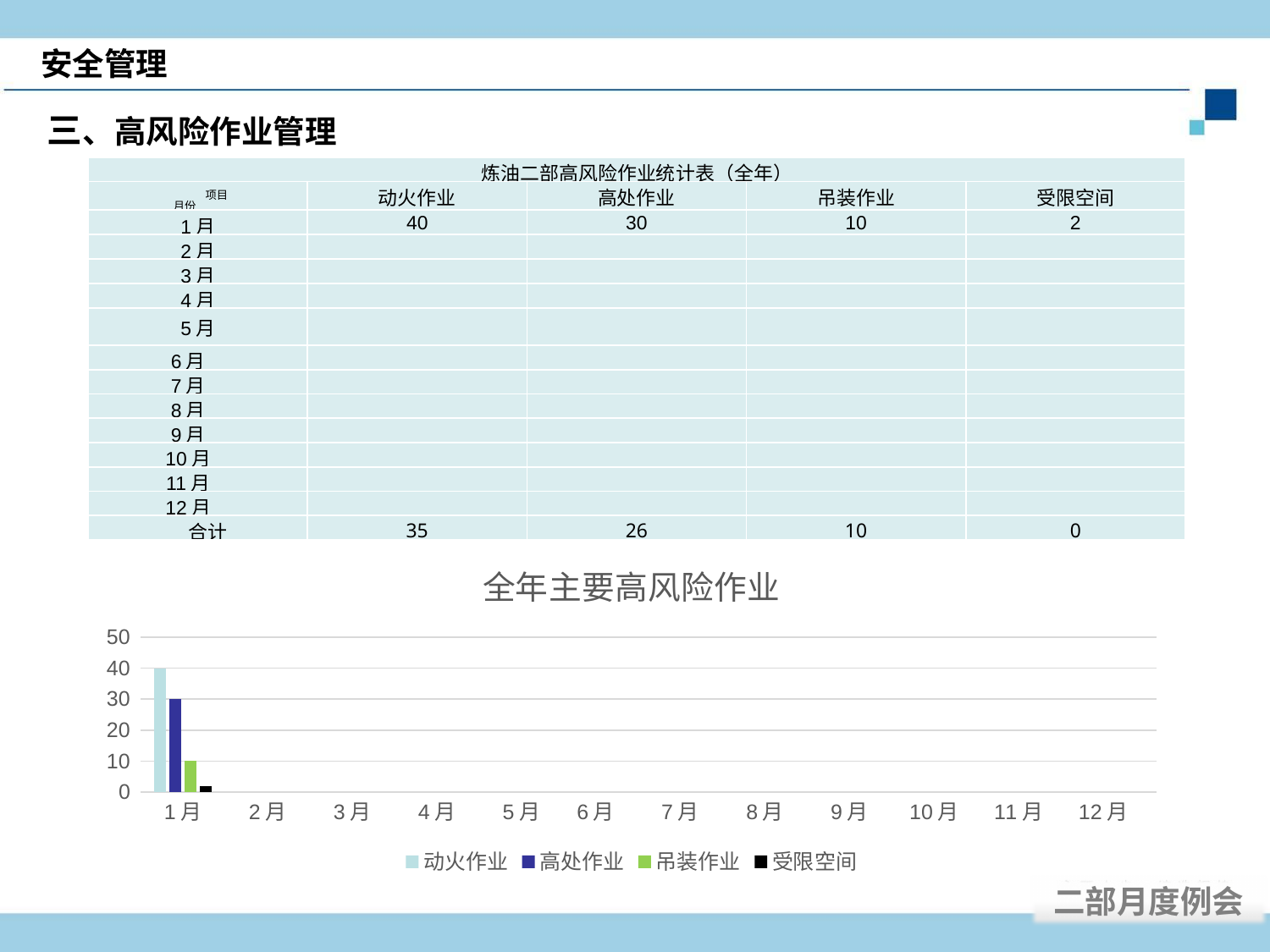
What is the value of 高处作业 for 1月 in the chart? 30 What is the title of the chart? 全年主要高风险作业 How many series does the chart legend list? 4 What is the value of 动火作业 for 1月 in the chart? 40 Is the value for 受限空间 in 1月 greater or less than 10? less What is the value of 吊装作业 for 1月 in the chart? 10 Which series has the lowest value for 1月 in the chart? 受限空间 What kind of chart is shown on the slide? bar chart What is the difference between 动火作业 and 高处作业 for 1月 in the chart? 10 For 1月, which is larger in the chart: 高处作业 or 吊装作业? 高处作业 Which series has the highest value for 1月 in the chart? 动火作业 How many month categories are shown on the x axis of the chart? 12